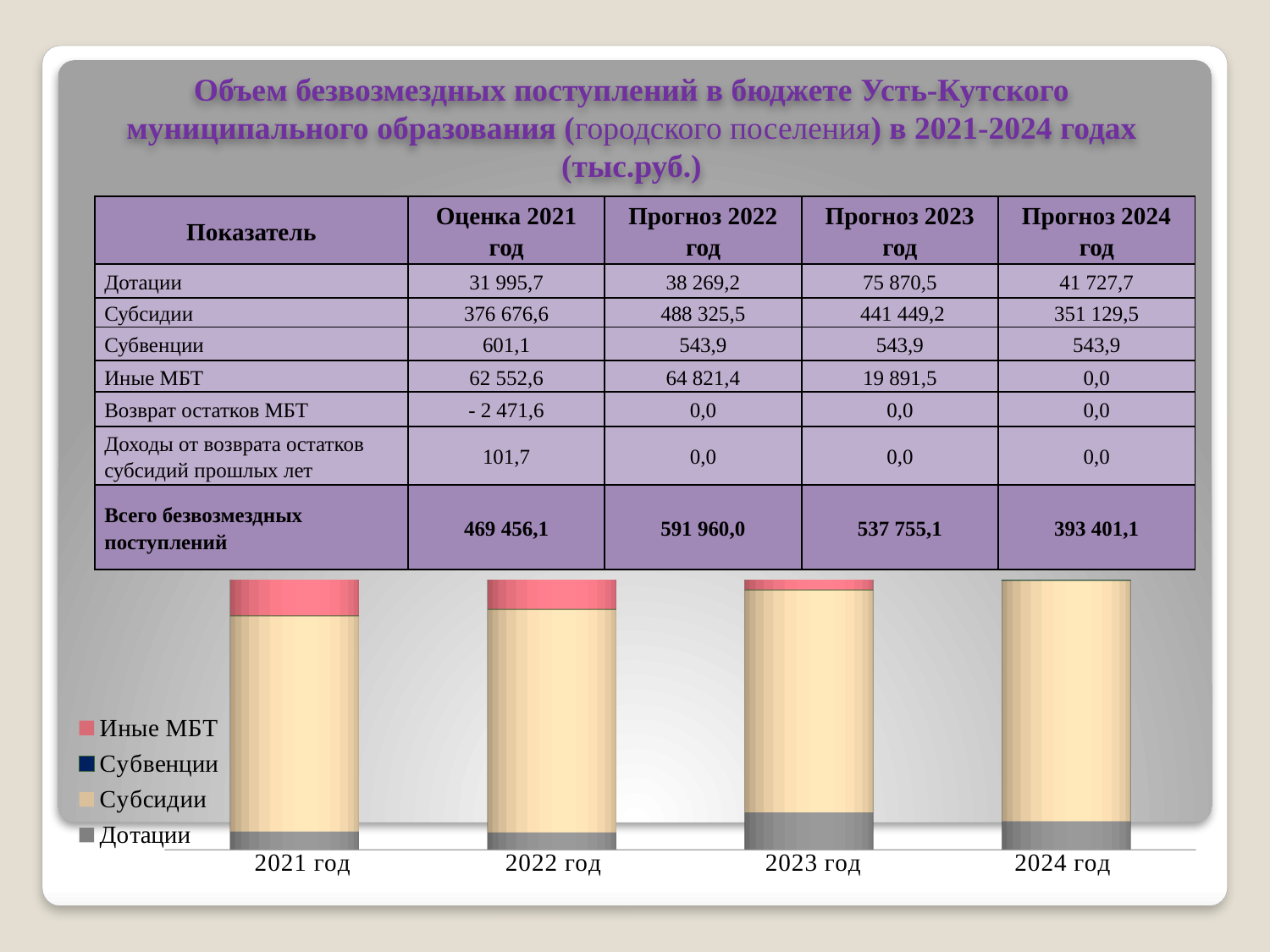
Which series is shown at the top of each stacked bar in the chart? Иные МБТ Which year in the chart has the smallest (no visible) Иные МБТ segment? 2024 год What kind of chart is shown at the bottom of the slide? Stacked bar chart According to the table, which year has the highest total of Всего безвозмездных поступлений? Прогноз 2022 год According to the table, what is the value of Субсидии for Прогноз 2022 год? 488 325,5 How many series does the chart legend list? 4 In the chart, is the Дотации segment larger in 2021 год or in 2023 год? 2023 год In the chart, is the Иные МБТ segment larger in 2021 год or in 2023 год? 2021 год According to the table, what is the value of Дотации for Прогноз 2023 год? 75 870,5 What colour represents Субсидии in the chart? Beige (cream) How many years (categories) are shown on the x axis of the chart? 4 Which series takes up the largest share of every bar in the chart? Субсидии